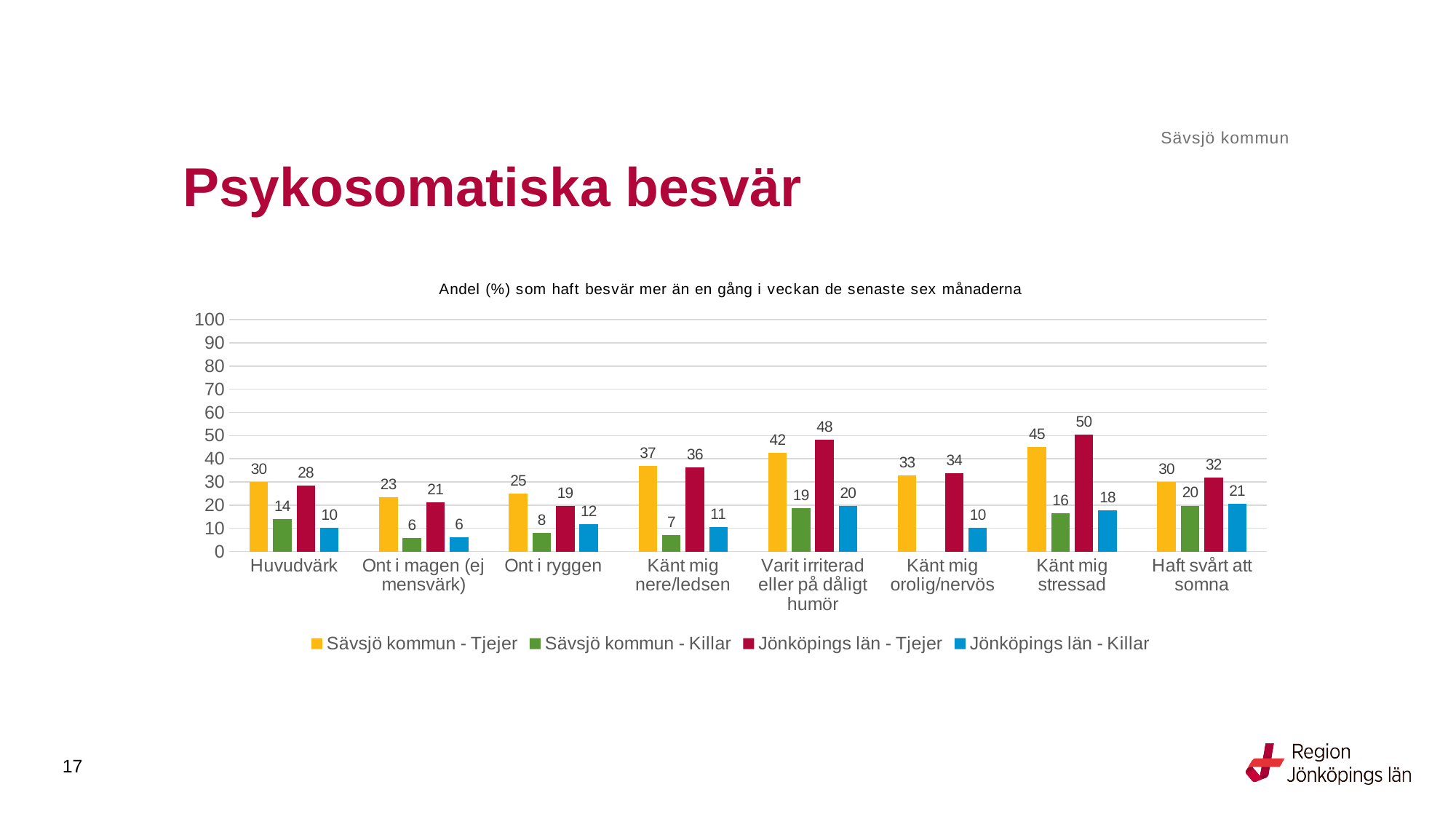
What is the value for Jönköpings län - Killar for Känt mig stressad? 18 What is the value for Sävsjö kommun - Tjejer for Huvudvärk? 30 What kind of chart is shown on the slide? bar chart How many series does the legend list? 4 Which category has the highest value for Jönköpings län - Tjejer? Känt mig stressad What is the difference between Jönköpings län - Tjejer and Sävsjö kommun - Tjejer for Varit irriterad eller på dåligt humör? 6 Which is larger for Ont i ryggen: Sävsjö kommun - Killar or Jönköpings län - Killar? Jönköpings län - Killar Is the value for Sävsjö kommun - Tjejer for Känt mig stressad greater or less than 40? greater Which category has no bar for Sävsjö kommun - Killar? Känt mig orolig/nervös Which category has the lowest value for Sävsjö kommun - Tjejer? Ont i magen (ej mensvärk) How many categories are shown on the x axis? 8 What is the value for Sävsjö kommun - Killar for Varit irriterad eller på dåligt humör? 19